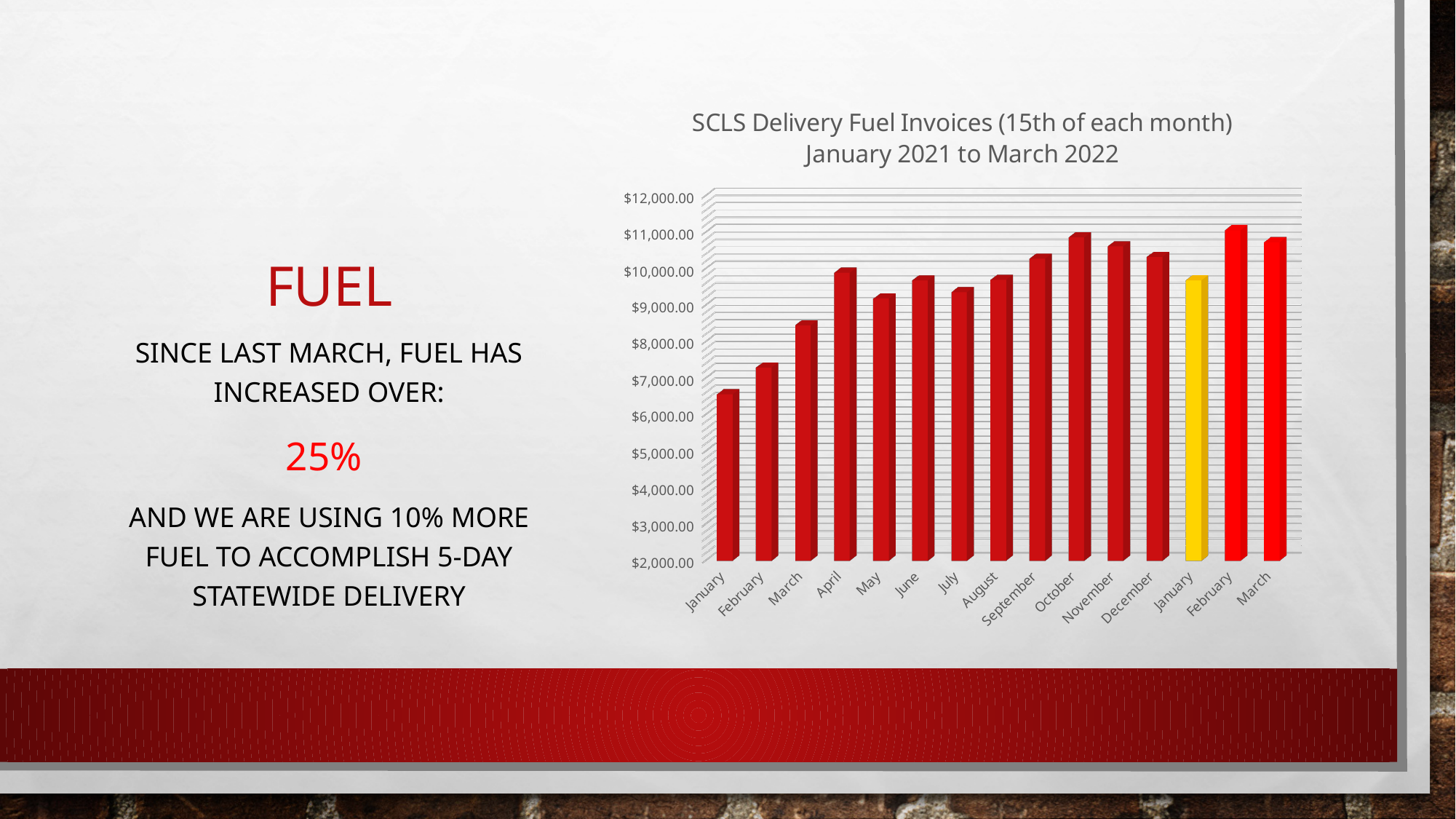
Is the value for March 2021 greater or less than $8,000.00? greater Which is larger, the value for April 2021 or the value for May 2021? April 2021 Is the value for January 2021 greater or less than $7,000.00? less Which month's bar is coloured yellow instead of red? January (2022) Is the value for October 2021 greater or less than $10,000.00? greater Overall, do the fuel invoice values rise or fall from January 2021 to March 2022? Rise Which month has the lowest fuel invoice value in the chart? January (2021) How many monthly bars are plotted in the chart? 15 Which month has the highest fuel invoice value in the chart? February (2022) What kind of chart is shown on the slide? Bar chart What is the title of the chart? SCLS Delivery Fuel Invoices (15th of each month) January 2021 to March 2022